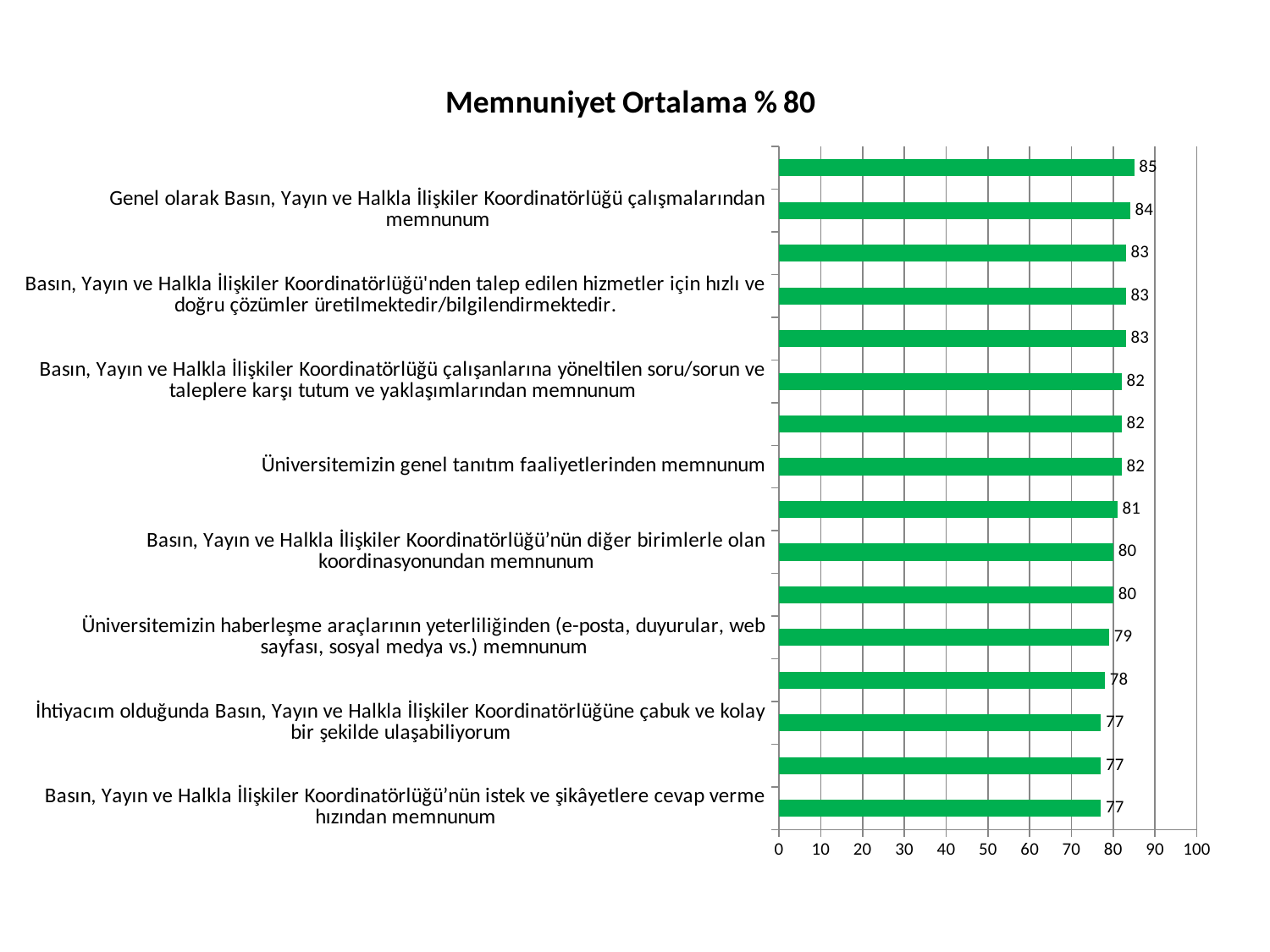
Which has a larger value: "Genel olarak Basın, Yayın ve Halkla İlişkiler Koordinatörlüğü çalışmalarından memnunum" or "Üniversitemizin haberleşme araçlarının yeterliliğinden (e-posta, duyurular, web sayfası, sosyal medya vs.) memnunum"? Genel olarak Basın, Yayın ve Halkla İlişkiler Koordinatörlüğü çalışmalarından memnunum Is the value for "İhtiyacım olduğunda Basın, Yayın ve Halkla İlişkiler Koordinatörlüğüne çabuk ve kolay bir şekilde ulaşabiliyorum" greater or less than 80? less What is the value for "Genel olarak Basın, Yayın ve Halkla İlişkiler Koordinatörlüğü çalışmalarından memnunum"? 84 What is the lowest value shown on any bar in the chart? 77 What is the title of the chart? Memnuniyet Ortalama % 80 What is the value for "Üniversitemizin genel tanıtım faaliyetlerinden memnunum"? 82 What kind of chart is shown on the slide? bar chart What is the difference between the highest bar value and the lowest bar value in the chart? 8 What is the maximum value shown on the horizontal axis of the chart? 100 What is the highest value shown on any bar in the chart? 85 How many bars are plotted in the chart? 16 What is the value for "Üniversitemizin haberleşme araçlarının yeterliliğinden (e-posta, duyurular, web sayfası, sosyal medya vs.) memnunum"? 79